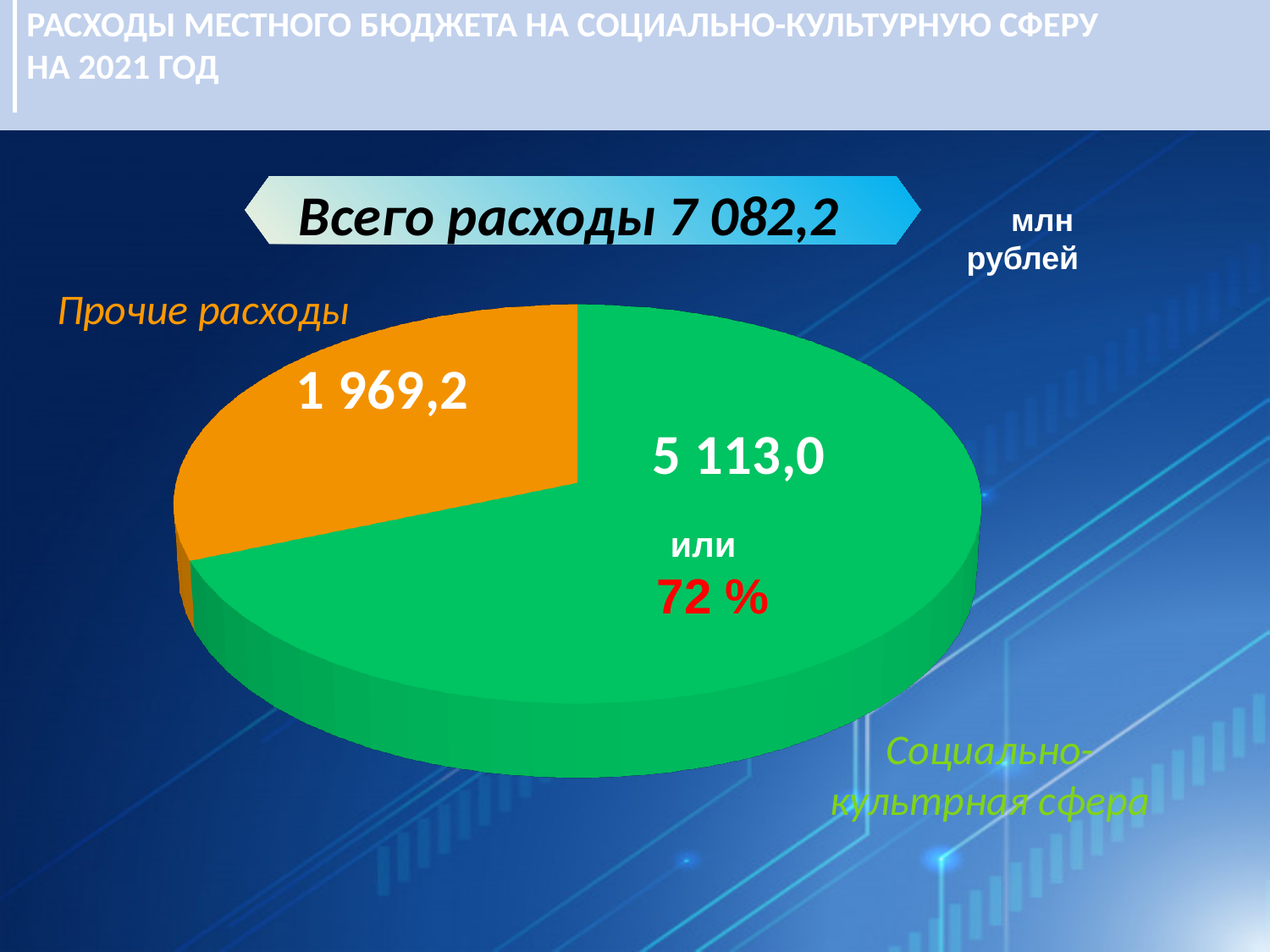
What colour is the slice for Прочие расходы? orange What is the total of all expenditures shown on the slide? 7 082,2 Which slice of the pie is the largest? Социально-культурная сфера In what units are the values on the slide expressed? млн рублей Which slice of the pie is the smallest? Прочие расходы What is the value for Прочие расходы? 1 969,2 What type of chart is shown on the slide? pie chart What is the value for Социально-культурная сфера? 5 113,0 How many slices does the pie chart have? 2 What share of the pie does Социально-культурная сфера represent? 72 % Which is larger: Прочие расходы or Социально-культурная сфера? Социально-культурная сфера What is the difference between the values for Социально-культурная сфера and Прочие расходы? 3 143,8